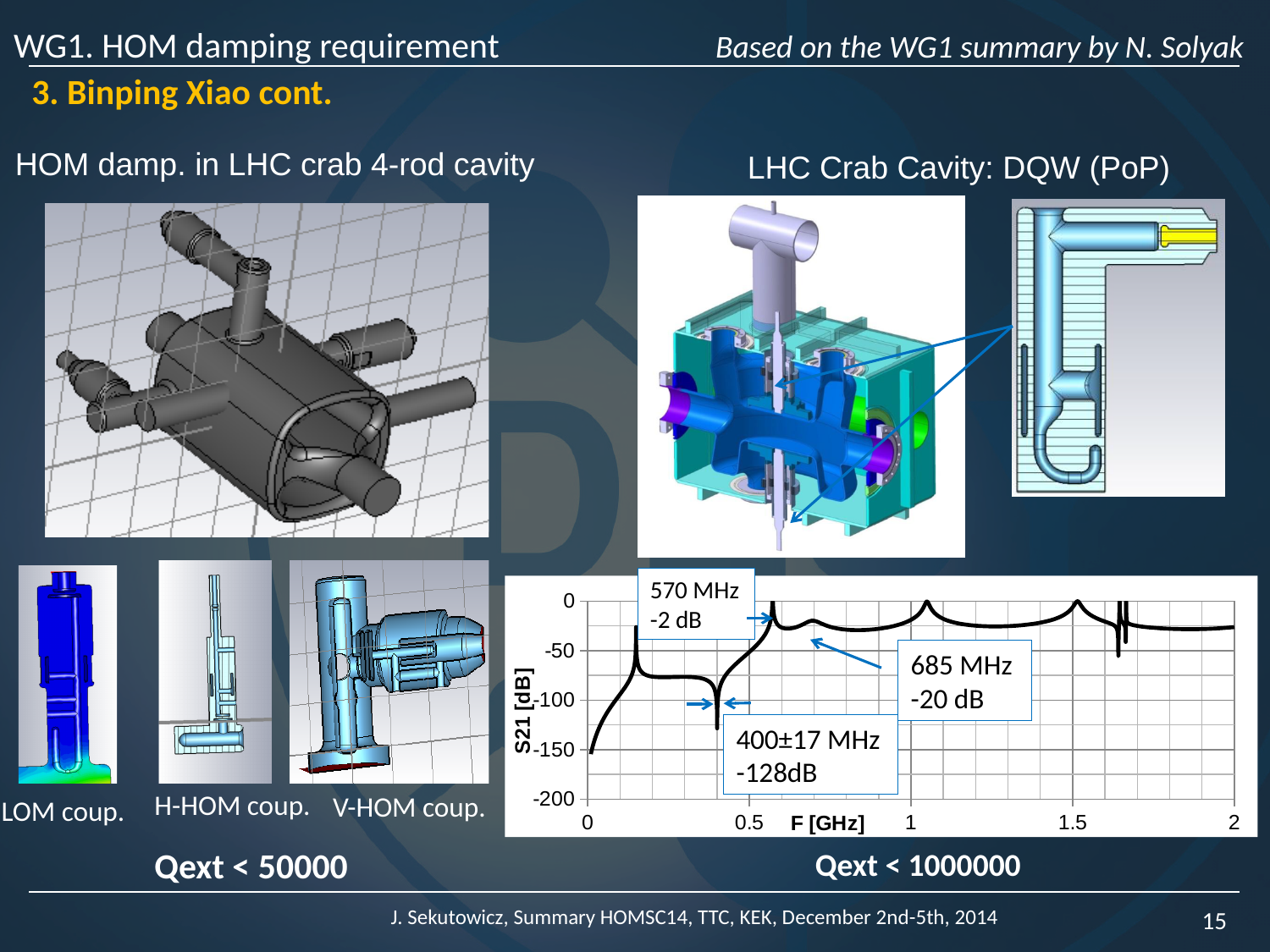
On the S21 chart, which annotated frequency has the lowest S21 value? 400±17 MHz According to the annotation on the S21 chart, what is the S21 value at 400±17 MHz? -128dB What is the label of the vertical axis of the S21 chart? S21 [dB] On the S21 chart, what is the difference between the S21 values at 685 MHz and 570 MHz? 18 dB What is the maximum frequency shown on the horizontal axis of the S21 chart? 2 What is the label of the horizontal axis of the S21 chart? F [GHz] On the S21 chart, is the S21 value at 570 MHz larger or smaller than the value at 685 MHz? larger On the S21 chart, is the S21 value at 400±17 MHz greater or less than -100 dB? less What kind of chart is the S21 versus frequency plot on the slide? line chart According to the annotation on the S21 chart, what is the S21 value at 570 MHz? -2 dB On the S21 chart, which annotated frequency has the highest S21 value? 570 MHz According to the annotation on the S21 chart, what is the S21 value at 685 MHz? -20 dB